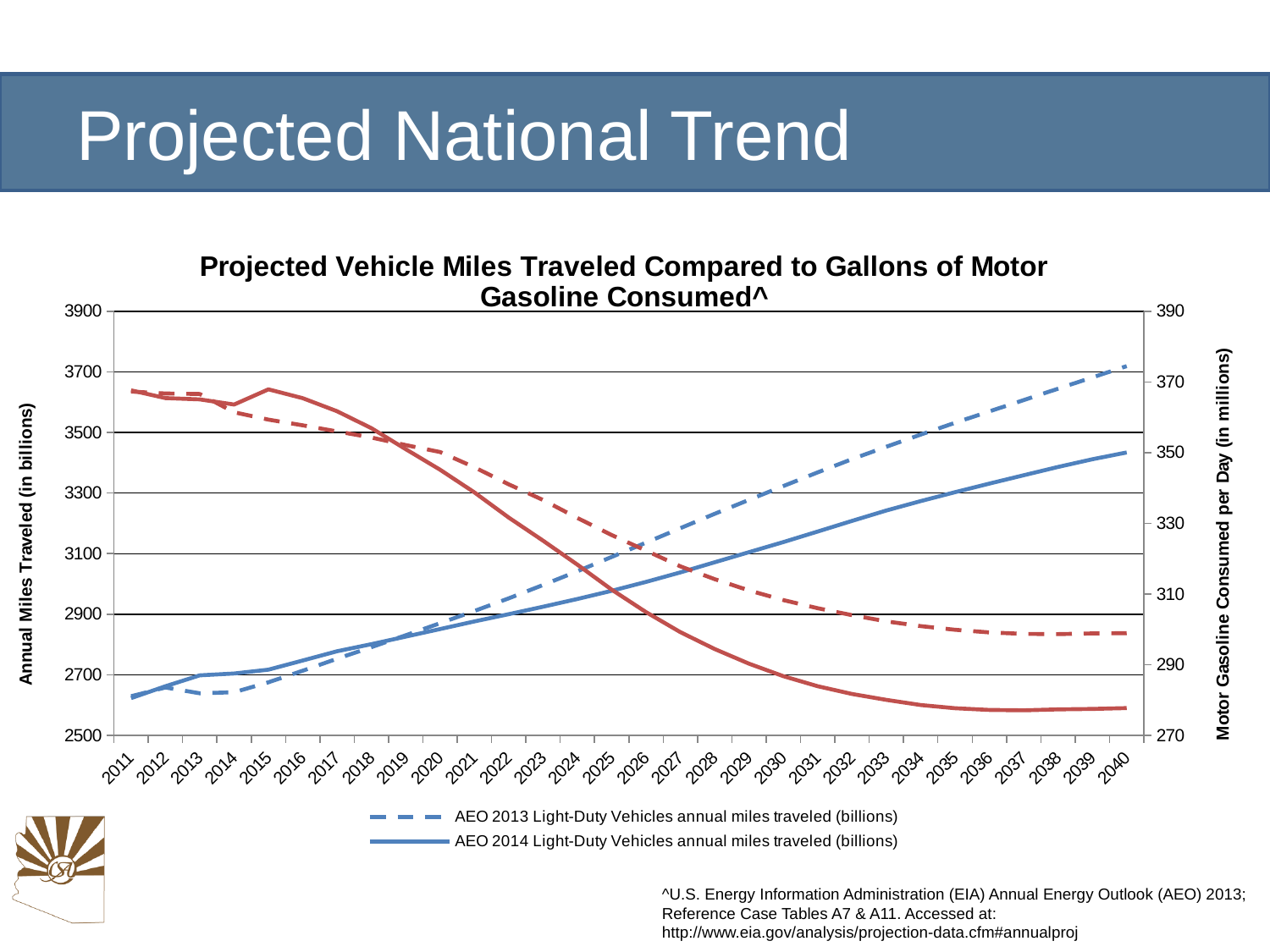
What kind of chart is shown on the slide? Line chart Is the value for AEO 2014 Light-Duty Vehicles annual miles traveled in 2011 greater or less than 2700? less Does the AEO 2014 Light-Duty Vehicles annual miles traveled line rise or fall from 2011 to 2040? Rise What is the title of the chart? Projected Vehicle Miles Traveled Compared to Gallons of Motor Gasoline Consumed^ Is the solid red line for motor gasoline consumed per day in 2040 greater or less than 290 on the right axis? less How many years are shown along the x axis of the chart? 30 How many series does the chart's legend list? 2 Do the red lines for motor gasoline consumed rise or fall from 2011 to 2040? Fall Is the value for AEO 2014 Light-Duty Vehicles annual miles traveled in 2040 greater or less than 3300? greater In 2040, which is higher: the AEO 2013 or the AEO 2014 Light-Duty Vehicles annual miles traveled line? AEO 2013 What is the label of the left vertical axis? Annual Miles Traveled (in billions)